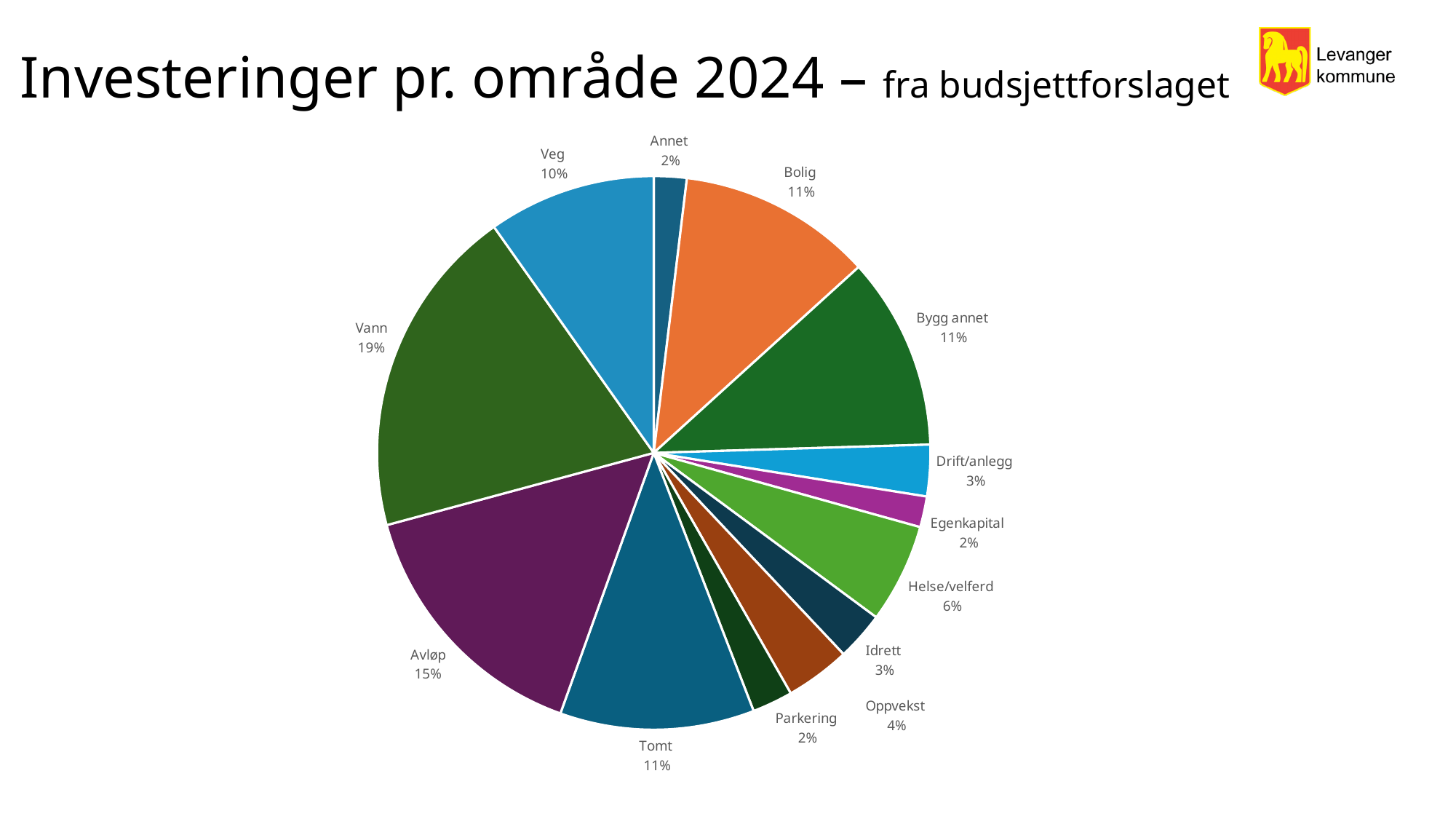
What is the difference in percentage points between Vann and Avløp? 4 What share of the pie does Vann account for? 19% What is the value shown for Veg? 10% What kind of chart is shown on the slide? pie chart What is the title of the slide containing the chart? Investeringer pr. område 2024 – fra budsjettforslaget How many categories are shown in the pie chart? 13 Which category has the largest slice of the pie? Vann What is the value shown for Drift/anlegg? 3% Which is larger, the slice for Veg or the slice for Oppvekst? Veg What is the difference in percentage points between Bolig and Idrett? 8 What is the value shown for Helse/velferd? 6% What is the value shown for Avløp? 15%